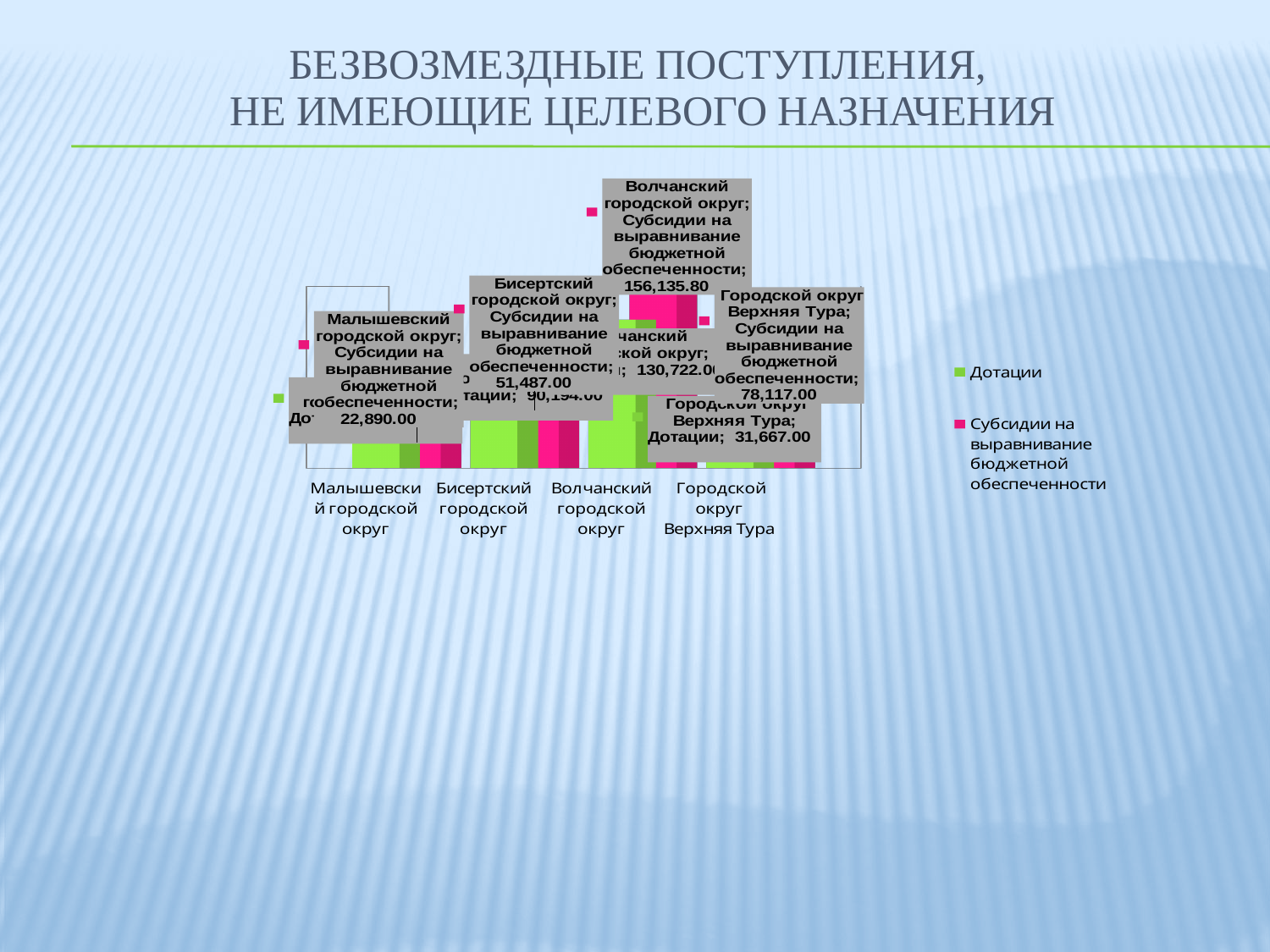
What is the value of Субсидии на выравнивание бюджетной обеспеченности for Городской округ Верхняя Тура? 78,117.00 What is the difference between the Субсидии values for Волчанский городской округ and Малышевский городской округ? 133,245.80 What kind of chart is shown on the slide? bar chart What is the value of Субсидии на выравнивание бюджетной обеспеченности for Малышевский городской округ? 22,890.00 How many series does the legend list? 2 What is the value of Дотации for Городской округ Верхняя Тура? 31,667.00 What is the value of Субсидии на выравнивание бюджетной обеспеченности for Волчанский городской округ? 156,135.80 How many categories (городские округа) are shown on the x axis? 4 What is the value of Субсидии на выравнивание бюджетной обеспеченности for Бисертский городской округ? 51,487.00 Which category has the highest value of Субсидии на выравнивание бюджетной обеспеченности? Волчанский городской округ Which category has the lowest value of Субсидии на выравнивание бюджетной обеспеченности? Малышевский городской округ Which colour represents Дотации in the legend? green